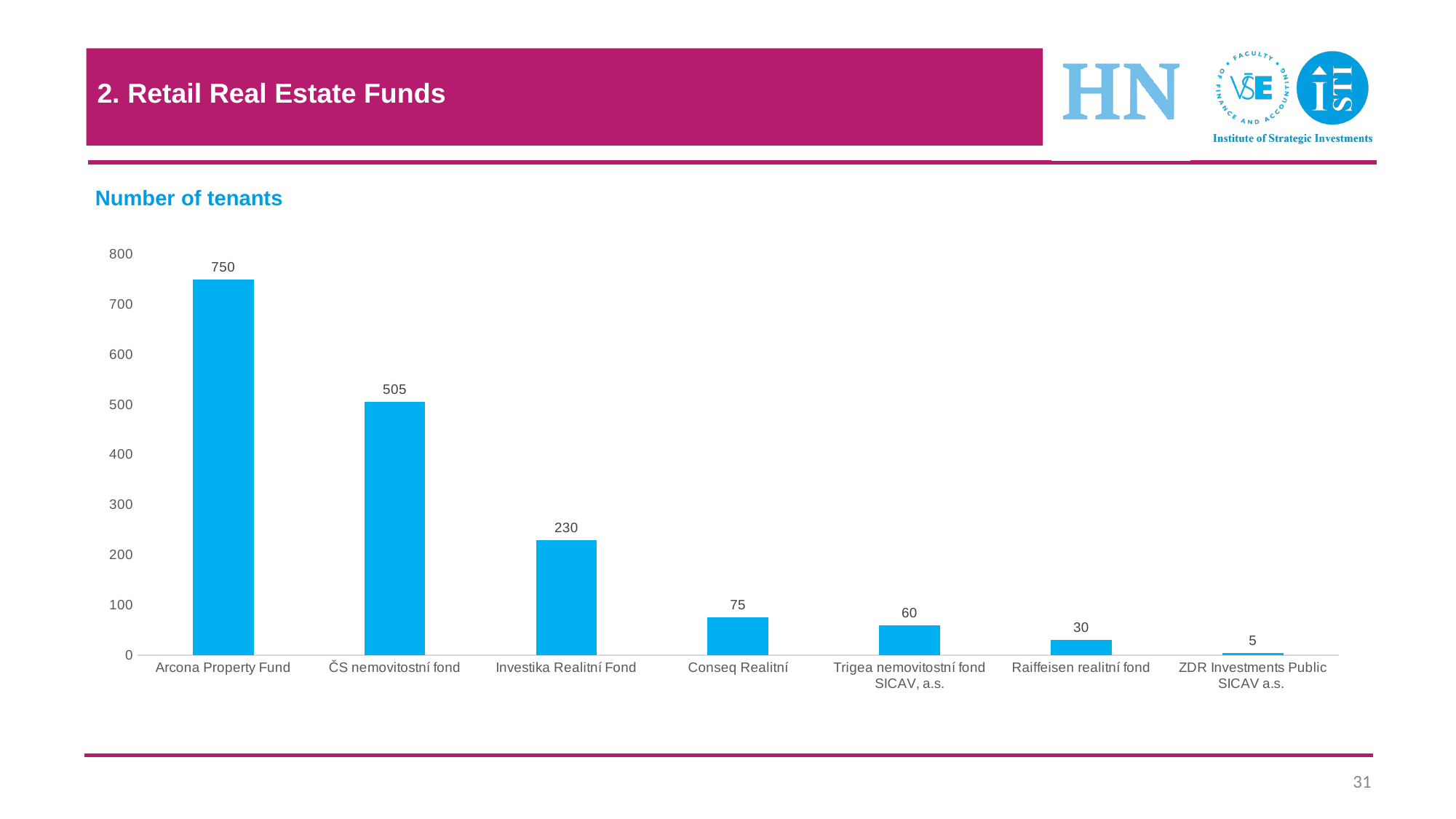
What is the number of tenants for Investika Realitní Fond? 230 What is the title of the chart? Number of tenants What is the difference in number of tenants between Arcona Property Fund and ČS nemovitostní fond? 245 Which fund has the highest number of tenants? Arcona Property Fund Which fund has the lowest number of tenants? ZDR Investments Public SICAV a.s. What is the difference in number of tenants between Conseq Realitní and Trigea nemovitostní fond SICAV, a.s.? 15 What is the number of tenants for Arcona Property Fund? 750 Which has more tenants, ČS nemovitostní fond or Investika Realitní Fond? ČS nemovitostní fond What kind of chart is shown on the slide? Bar chart What is the number of tenants for Raiffeisen realitní fond? 30 Is the number of tenants for Conseq Realitní greater or less than 100? less How many funds are shown in the chart? 7